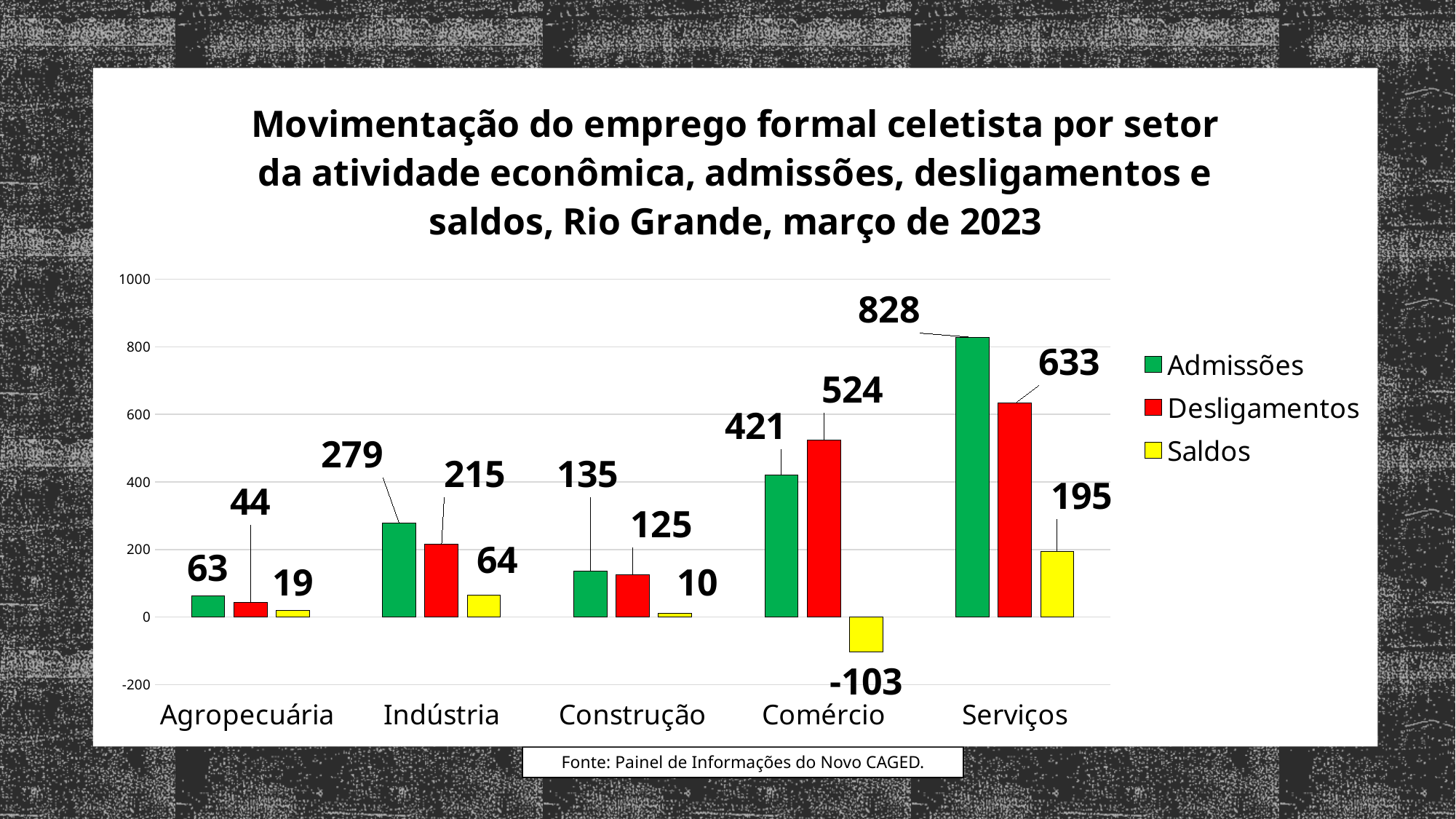
What is the value of Desligamentos for Comércio? 524 Which is larger for Construção, Admissões or Desligamentos? Admissões What is the value of Saldos for Comércio? -103 Which sector has the lowest Saldos value? Comércio What colour represents the Saldos series? Yellow How many series does the legend list? 3 Which sector has the highest Desligamentos value? Serviços What kind of chart is shown on the slide? Bar chart What is the value of Admissões for Serviços? 828 What is the value of Admissões for Agropecuária? 63 How many sectors are shown on the x axis? 5 What is the difference between Admissões and Desligamentos for Indústria? 64